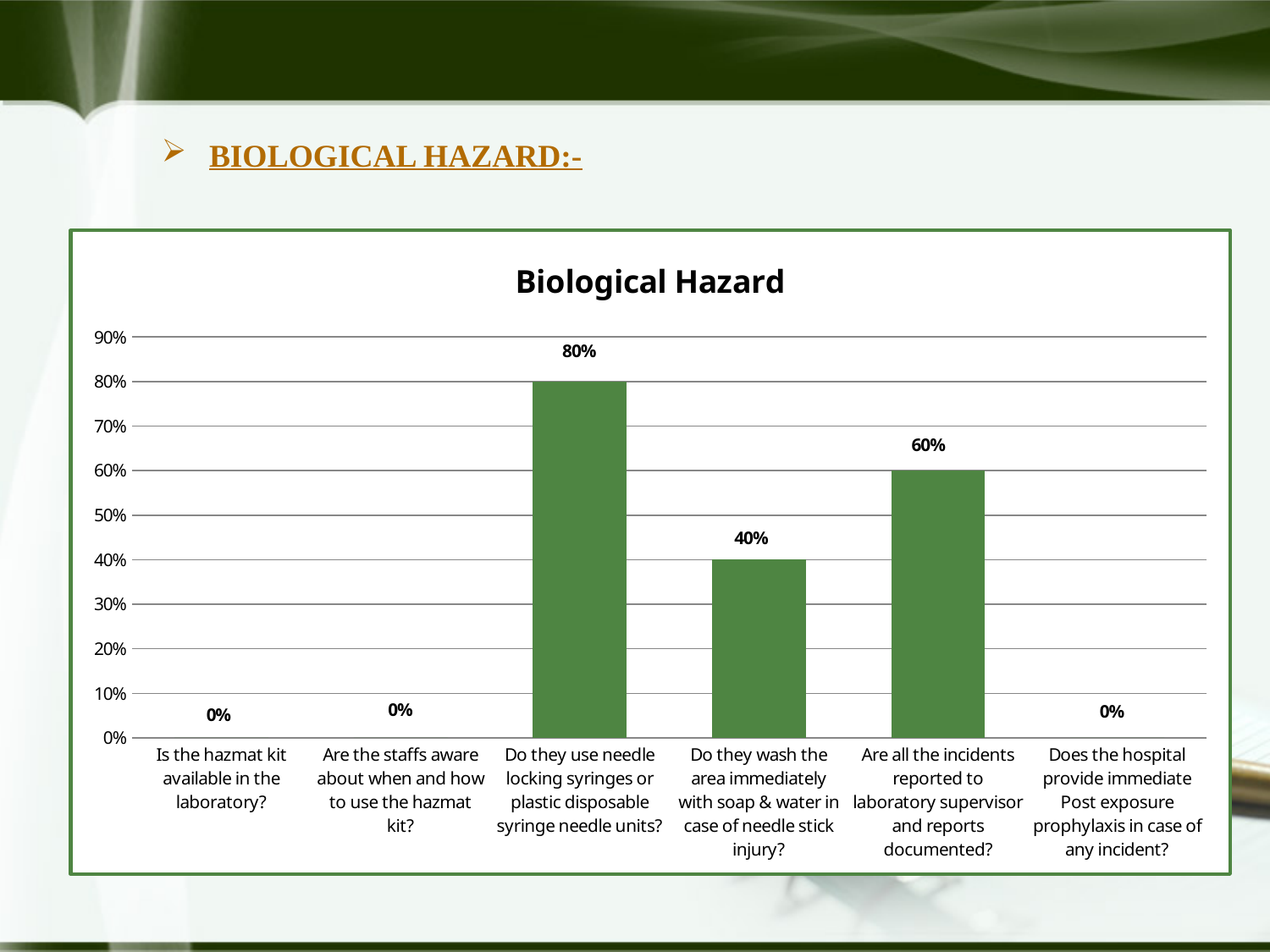
What kind of chart is shown? Bar chart How many categories are shown on the x axis? 6 What is the highest value shown on the y axis? 90% Which is larger: the value for "Are all the incidents reported to laboratory supervisor and reports documented?" or the value for "Do they wash the area immediately with soap & water in case of needle stick injury?"? Are all the incidents reported to laboratory supervisor and reports documented? How many categories have a value of 0%? 3 What is the difference between the values for "Do they use needle locking syringes or plastic disposable syringe needle units?" and "Do they wash the area immediately with soap & water in case of needle stick injury?"? 40% Which category has the highest value? Do they use needle locking syringes or plastic disposable syringe needle units? What is the value for "Are all the incidents reported to laboratory supervisor and reports documented?"? 60% What is the title of the chart? Biological Hazard What is the value for "Do they wash the area immediately with soap & water in case of needle stick injury?"? 40% What is the value for "Do they use needle locking syringes or plastic disposable syringe needle units?"? 80% What is the value for "Is the hazmat kit available in the laboratory?"? 0%